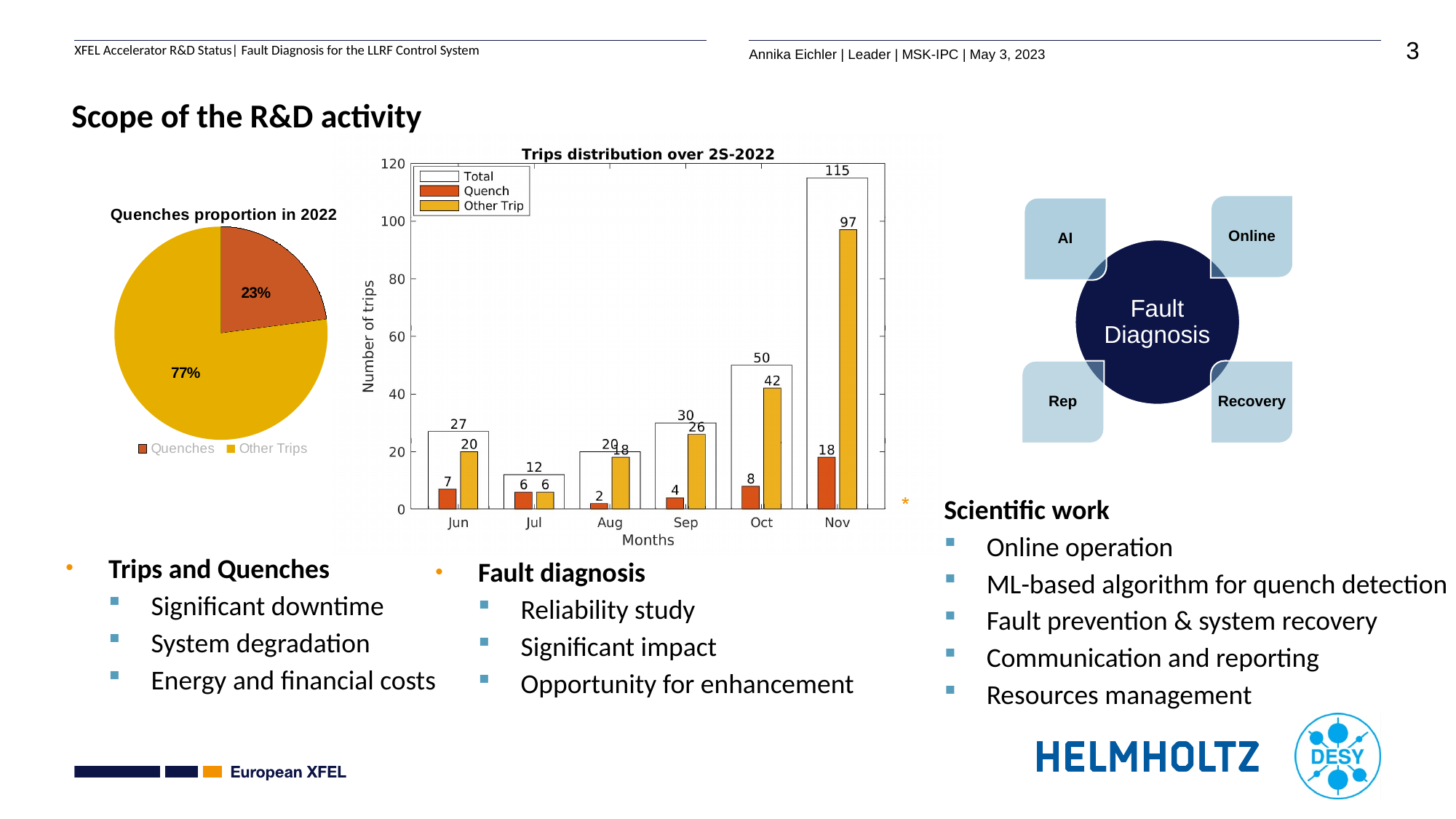
In the 'Quenches proportion in 2022' pie chart, what share of the pie is Other Trips? 77% In the 'Trips distribution over 2S-2022' chart, what is the Other Trip value for Sep? 26 In the 'Trips distribution over 2S-2022' chart, is the Quench value for Jun larger or smaller than the Quench value for Aug? Larger In the 'Trips distribution over 2S-2022' chart, which month has the lowest Total number of trips? Jul What kind of chart is 'Trips distribution over 2S-2022'? Bar chart In the 'Trips distribution over 2S-2022' chart, what is the Total number of trips in Nov? 115 In the 'Quenches proportion in 2022' pie chart, what share of the pie is Quenches? 23% How many months are shown on the x axis of the 'Trips distribution over 2S-2022' chart? 6 How many series does the legend of the 'Trips distribution over 2S-2022' chart list? 3 In the 'Trips distribution over 2S-2022' chart, which month has the highest Quench value? Nov In the 'Trips distribution over 2S-2022' chart, what is the difference between the Other Trip values for Nov and Oct? 55 In the 'Trips distribution over 2S-2022' chart, what is the Quench value for Oct? 8